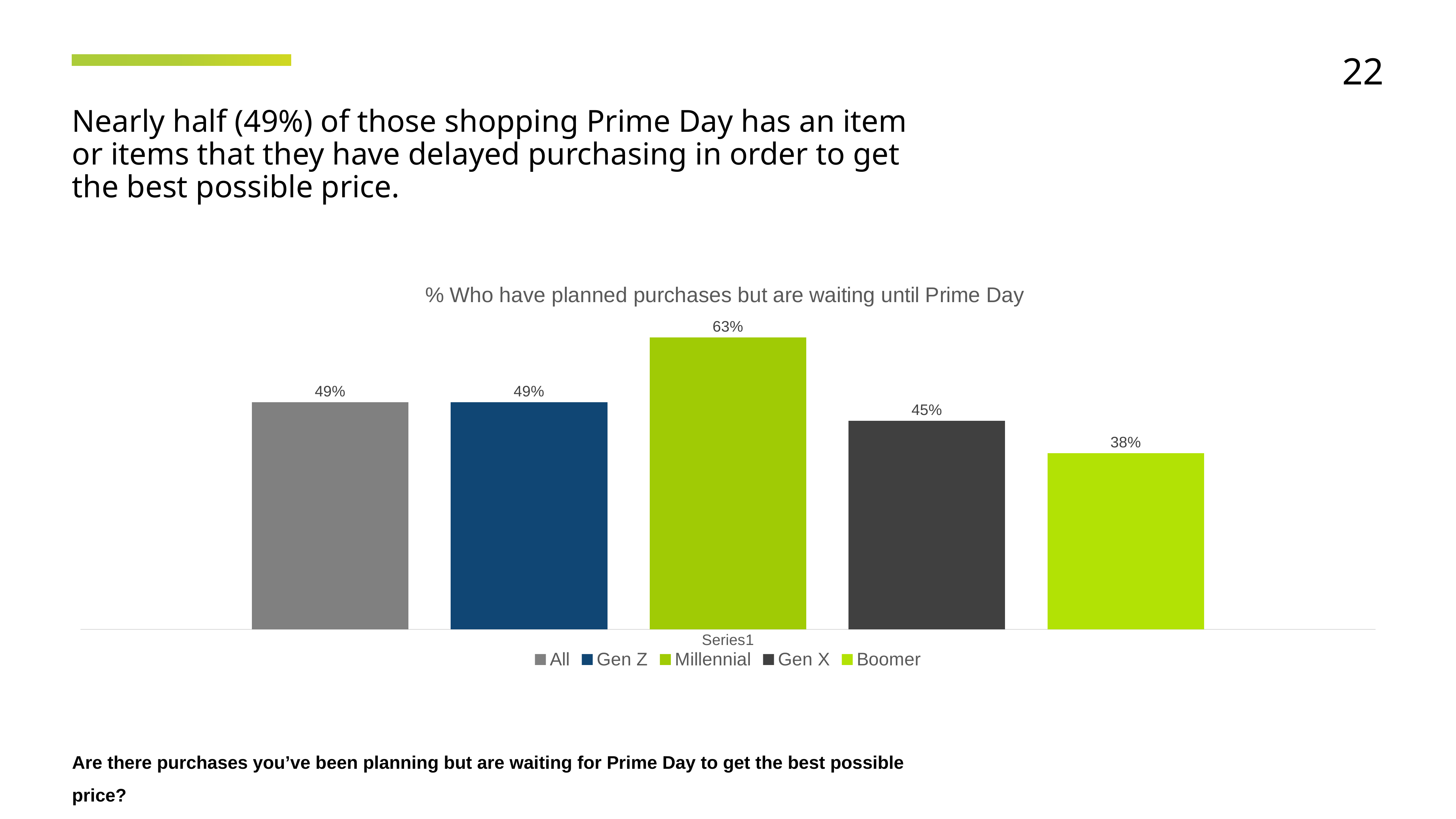
What is the difference between the Millennial and Boomer values? 25% What is the title of the chart? % Who have planned purchases but are waiting until Prime Day What is the value for Gen Z? 49% What kind of chart is shown on the slide? Bar chart Which is larger, the value for Gen X or the value for Boomer? Gen X How many series does the legend list? 5 What is the value for Boomer? 38% What is the value for Gen X? 45% What is the difference between the All and Gen X values? 4% What is the value for Millennial? 63% Which group has the lowest value? Boomer Which group has the highest value? Millennial